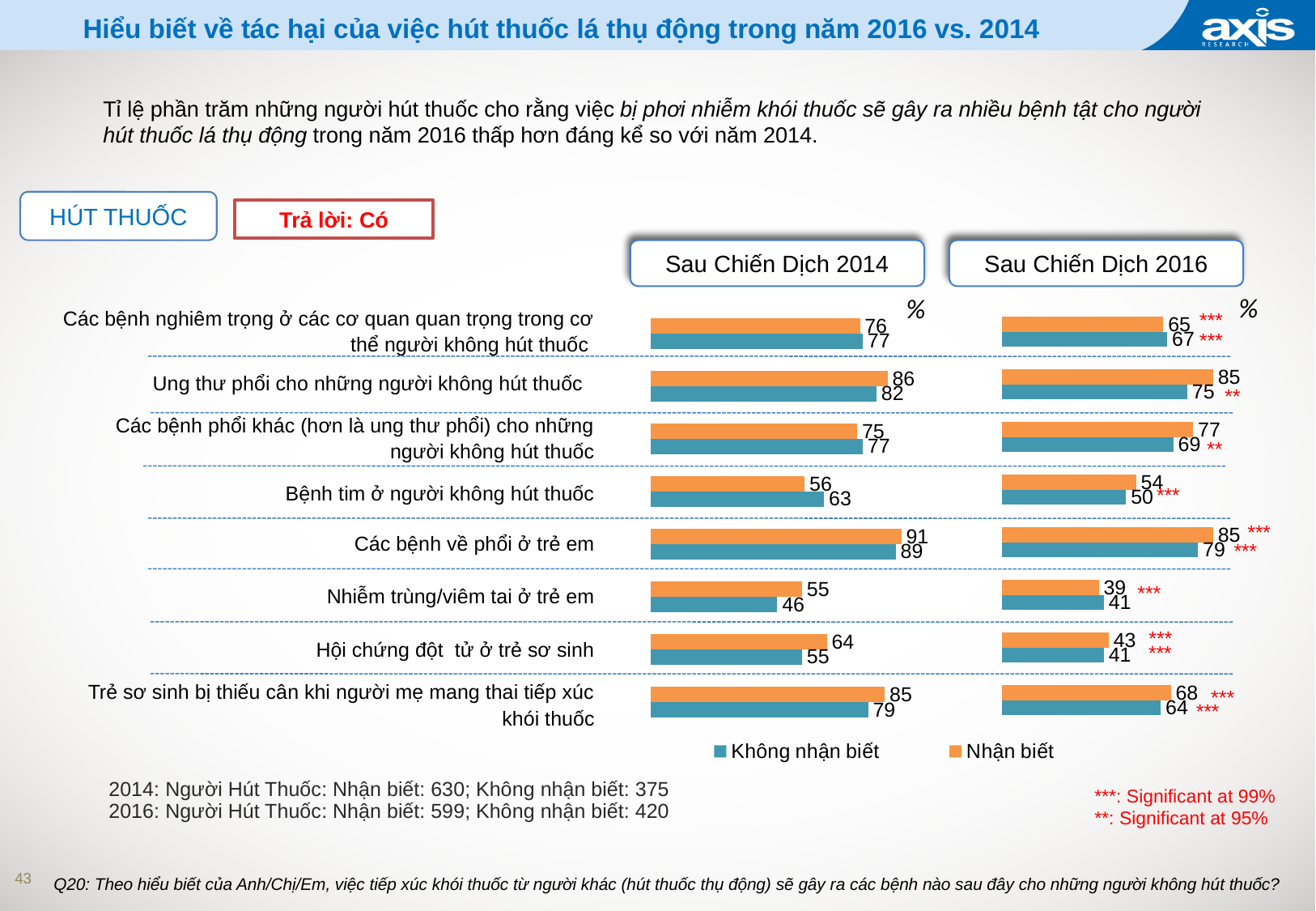
In the 'Sau Chiến Dịch 2014' chart, which category has the highest 'Nhận biết' value? Các bệnh về phổi ở trẻ em What type of chart is the 'Sau Chiến Dịch 2014' chart? Bar chart In the 'Sau Chiến Dịch 2014' chart, what is the value for 'Nhận biết' for 'Các bệnh về phổi ở trẻ em'? 91 In the 'Sau Chiến Dịch 2016' chart, what is the value for 'Không nhận biết' for 'Bệnh tim ở người không hút thuốc'? 50 How many categories are shown in the 'Sau Chiến Dịch 2016' chart? 8 In the 'Sau Chiến Dịch 2016' chart, what is the difference between the 'Nhận biết' and 'Không nhận biết' values for 'Ung thư phổi cho những người không hút thuốc'? 10 How many series does the legend list? 2 In the 'Sau Chiến Dịch 2014' chart, which is larger for 'Bệnh tim ở người không hút thuốc': 'Nhận biết' or 'Không nhận biết'? Không nhận biết In the 'Sau Chiến Dịch 2014' chart, which category has the lowest 'Không nhận biết' value? Nhiễm trùng/viêm tai ở trẻ em In the 'Sau Chiến Dịch 2014' chart, what is the difference between the 'Nhận biết' and 'Không nhận biết' values for 'Hội chứng đột tử ở trẻ sơ sinh'? 9 In the 'Sau Chiến Dịch 2016' chart, which category has the lowest 'Nhận biết' value? Nhiễm trùng/viêm tai ở trẻ em In the 'Sau Chiến Dịch 2016' chart, what is the value for 'Nhận biết' for 'Nhiễm trùng/viêm tai ở trẻ em'? 39